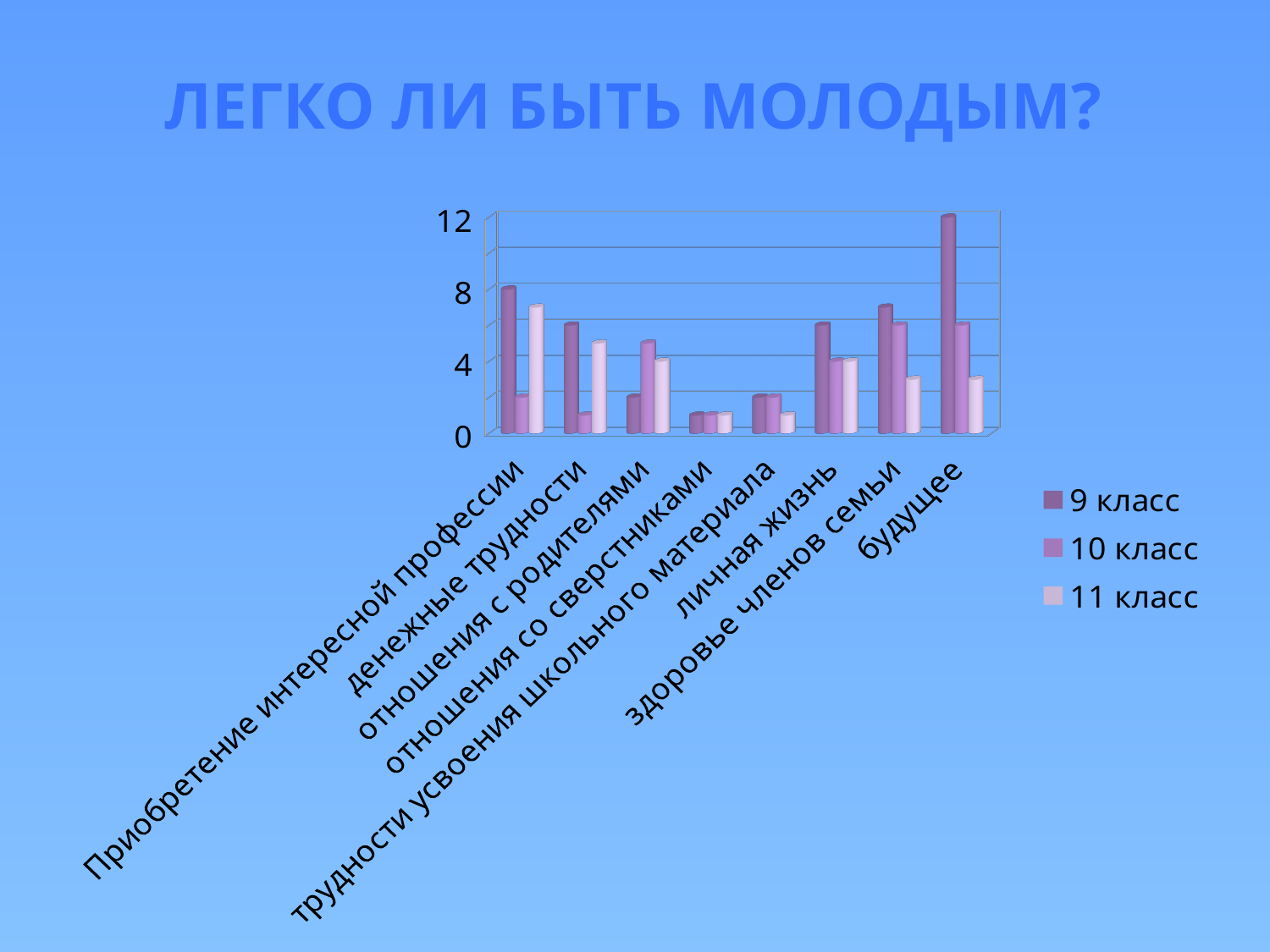
What is the title shown above the chart? ЛЕГКО ЛИ БЫТЬ МОЛОДЫМ? In the category денежные трудности, which is larger: 10 класс or 11 класс? 11 класс In the category Приобретение интересной профессии, which is larger: 9 класс or 10 класс? 9 класс Is the value for 9 класс in the category Приобретение интересной профессии greater or less than 4? greater In the category здоровье членов семьи, which is larger: 9 класс or 11 класс? 9 класс For the 9 класс series, which category has the highest value? будущее What are the three entries in the chart legend? 9 класс, 10 класс, 11 класс What kind of chart is shown on the slide? bar chart Is the value for 10 класс in the category денежные трудности greater or less than 4? less How many categories are shown along the x axis? 8 Is the value for 9 класс in the category будущее greater or less than 8? greater How many series does the legend list? 3